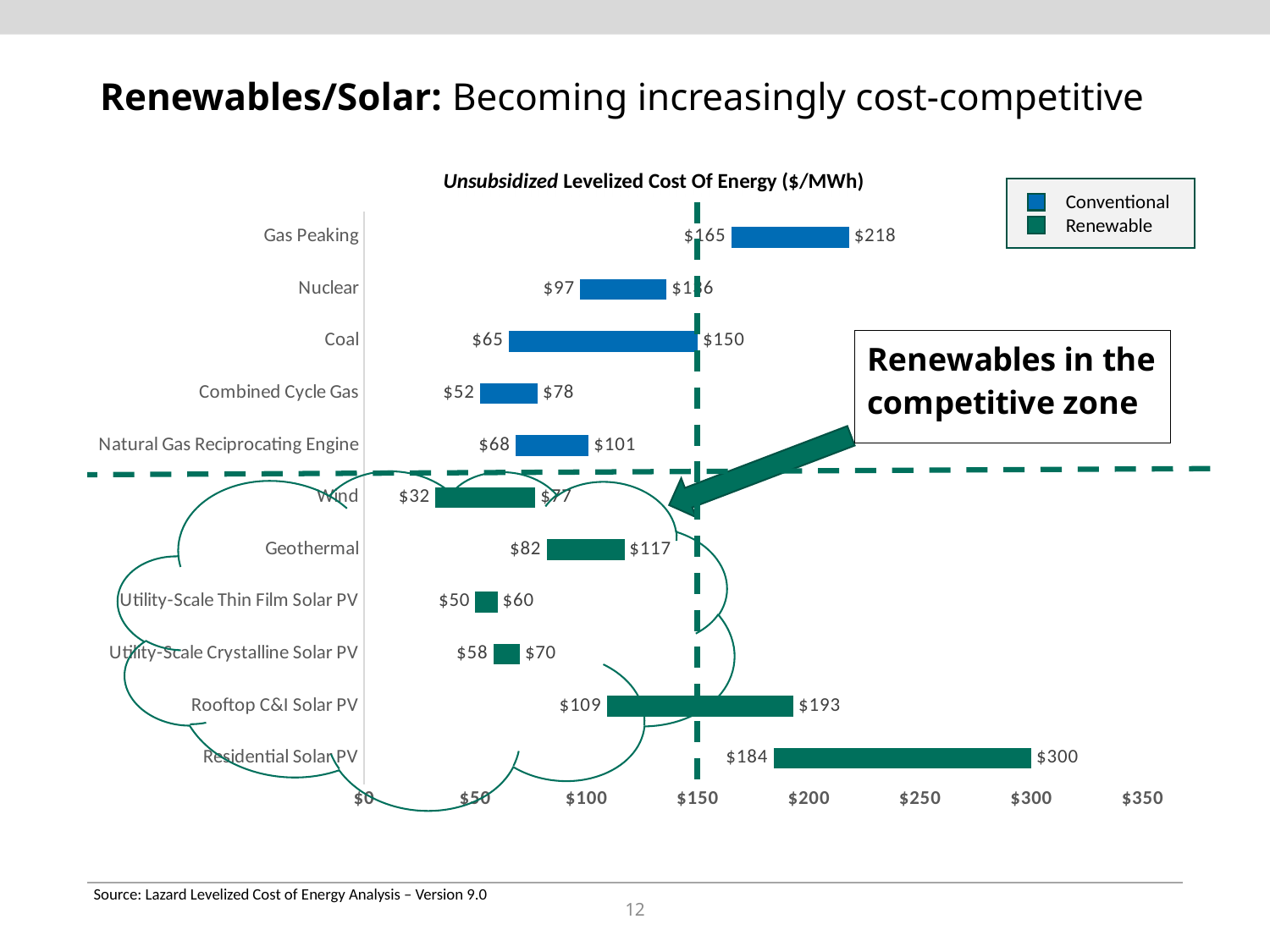
How many technologies are listed on the chart? 11 Which technology has the lowest low-end cost value on the chart? Wind What is the difference between the high and low ends of the Gas Peaking cost range? $53 What type of chart is shown on the slide? Bar chart Which has a higher upper cost value, Geothermal or Combined Cycle Gas? Geothermal How many series does the legend list? 2 What is the high end of the unsubsidized levelized cost range for Gas Peaking? $218 Which technology has the highest upper cost value on the chart? Residential Solar PV What is the low end of the cost range for Coal? $65 What is the low end of the cost range for Utility-Scale Thin Film Solar PV? $50 Is the high end of the Residential Solar PV range greater or less than $250? greater What is the high end of the cost range for Rooftop C&I Solar PV? $193